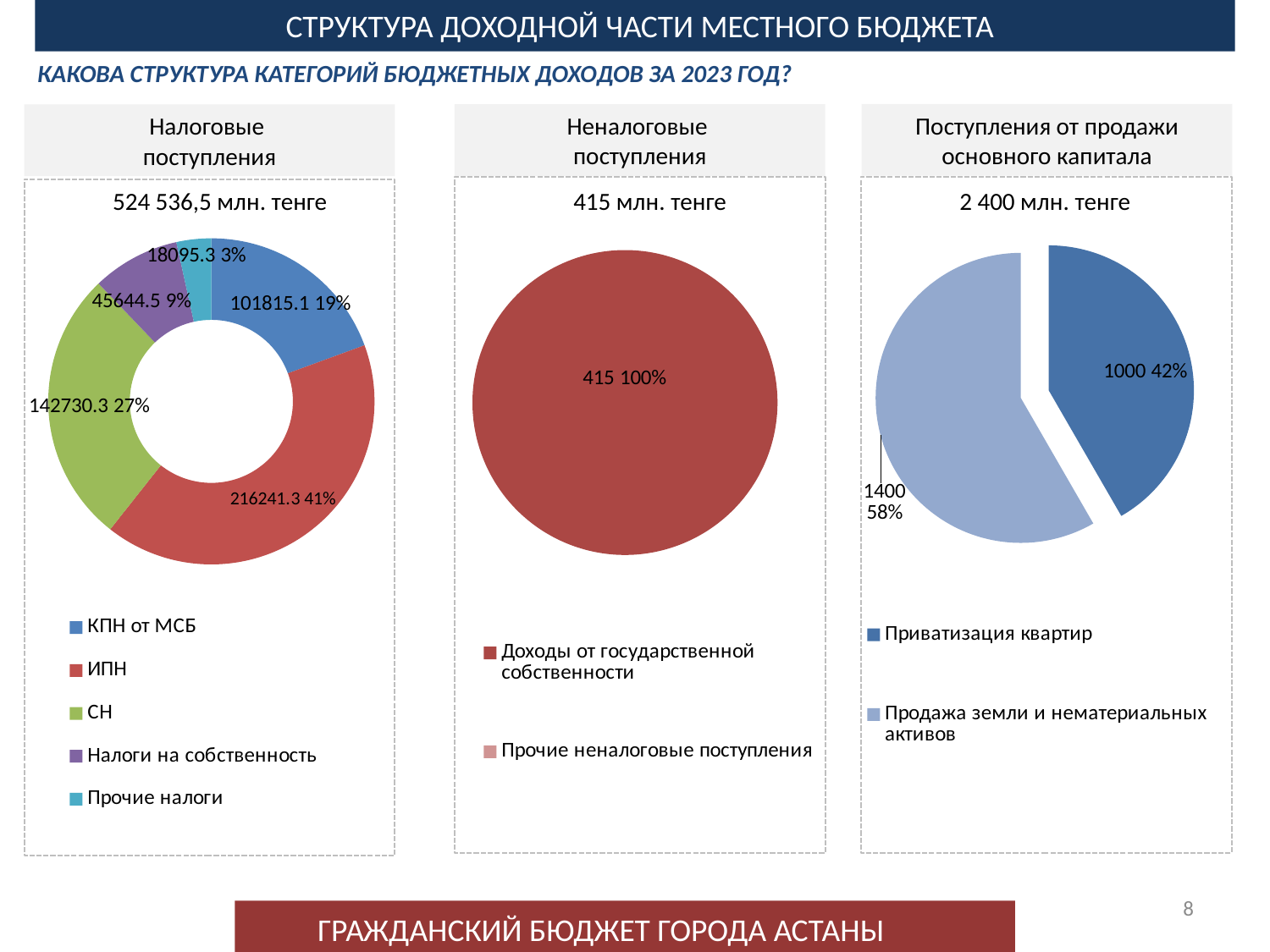
In the 'Налоговые поступления' chart, which category has the largest share? ИПН In the 'Налоговые поступления' chart, what value is shown for ИПН? 216241.3 In the 'Налоговые поступления' chart, which is larger: КПН от МСБ or Налоги на собственность? КПН от МСБ In the 'Налоговые поступления' chart, what is the difference between the percentage shares of ИПН and КПН от МСБ? 22% In the 'Налоговые поступления' chart, what percentage share does СН have? 27% What type of chart is used for 'Неналоговые поступления'? pie chart In the 'Налоговые поступления' chart, which category has the smallest share? Прочие налоги In the 'Неналоговые поступления' chart, what value is shown for Доходы от государственной собственности? 415 In the 'Поступления от продажи основного капитала' chart, what percentage share does Продажа земли и нематериальных активов have? 58% In the 'Неналоговые поступления' chart, how many entries does the legend list? 2 In the 'Поступления от продажи основного капитала' chart, what is the difference between the values for Продажа земли и нематериальных активов and Приватизация квартир? 400 In the 'Налоговые поступления' chart, how many categories does the legend list? 5